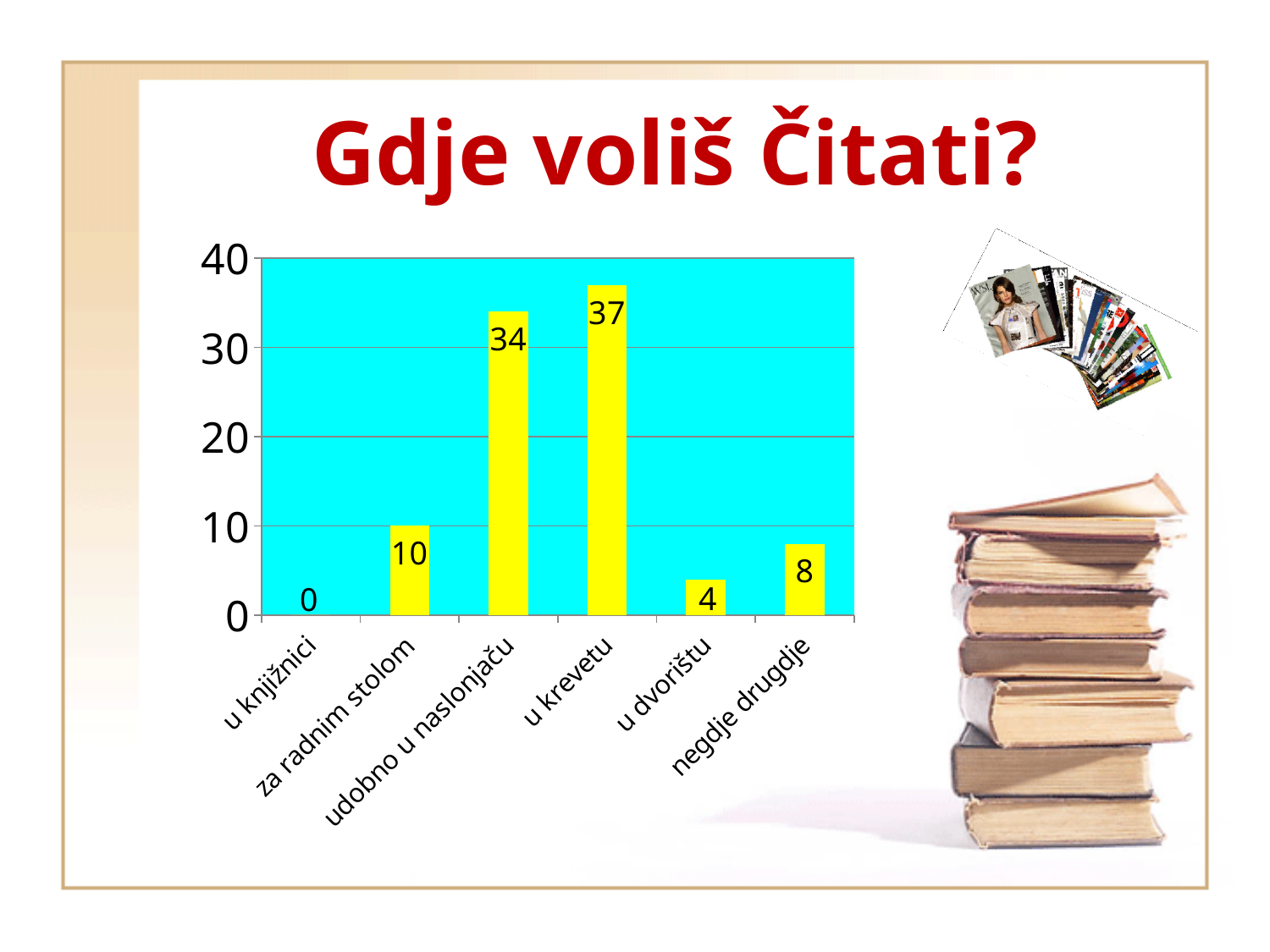
What is the value for "u dvorištu"? 4 How many categories are shown on the x axis? 6 What is the title of the slide? Gdje voliš čitati? What is the value for "za radnim stolom"? 10 Which category has the lowest value? u knjižnici What kind of chart is shown on the slide? bar chart Which is larger, the value for "za radnim stolom" or the value for "negdje drugdje"? za radnim stolom What is the value for "u krevetu"? 37 What is the value for "udobno u naslonjaču"? 34 Is the value for "udobno u naslonjaču" greater or less than 30? greater What is the difference between the values for "u krevetu" and "udobno u naslonjaču"? 3 Which category has the highest value? u krevetu